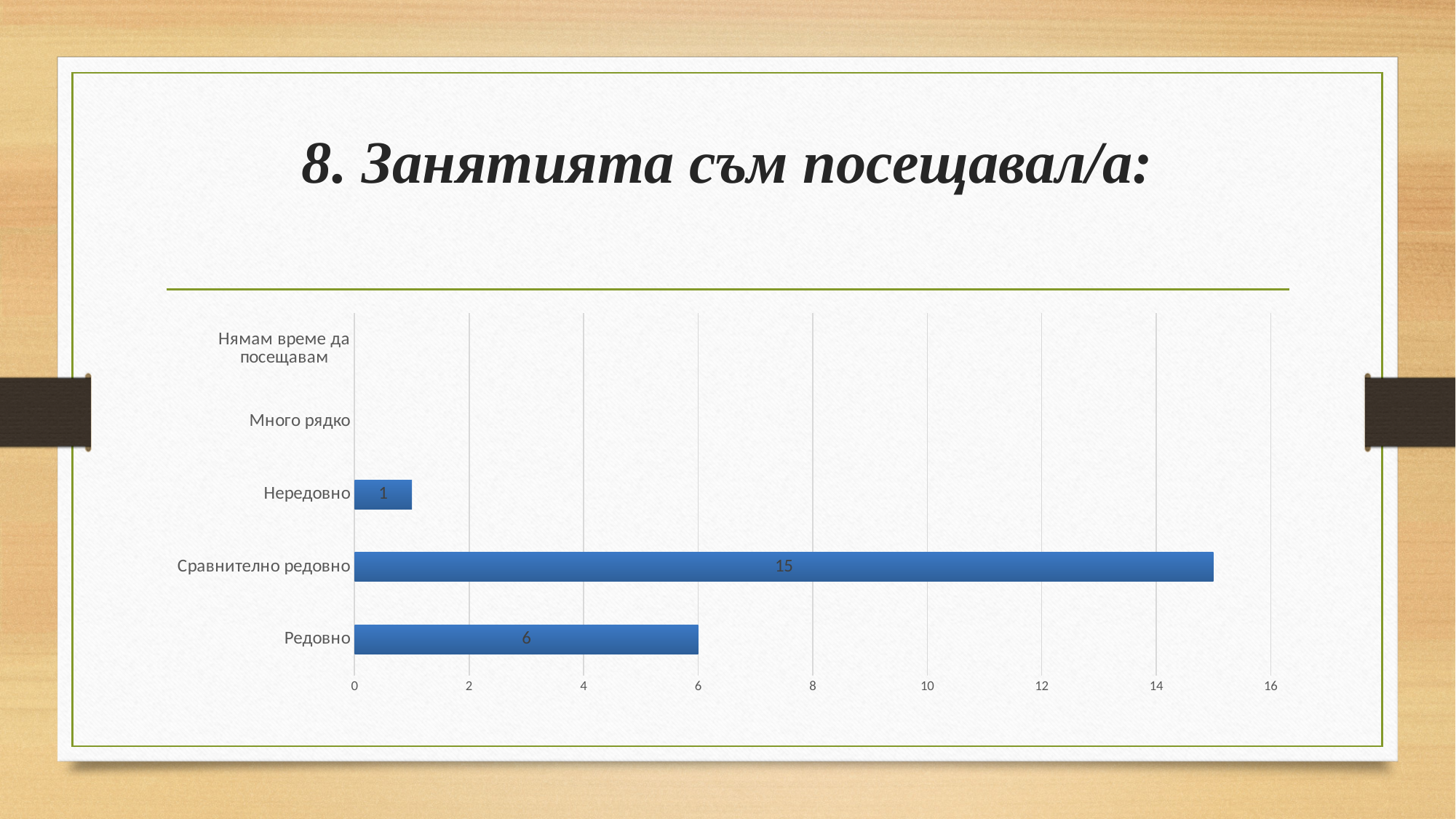
What kind of chart is shown on the slide? bar chart Which category has the highest value? Сравнително редовно Which is larger, the value for Редовно or the value for Нередовно? Редовно What is the difference between the values for Сравнително редовно and Редовно? 9 What is the value for Нередовно? 1 How many categories are listed on the vertical axis? 5 What is the value for Сравнително редовно? 15 Is the value for Сравнително редовно greater or less than 14? greater Which category with a visible bar has the lowest value? Нередовно What is the value for Редовно? 6 What is the difference between the values for Редовно and Нередовно? 5 What is the title of the slide? 8. Занятията съм посещавал/а: